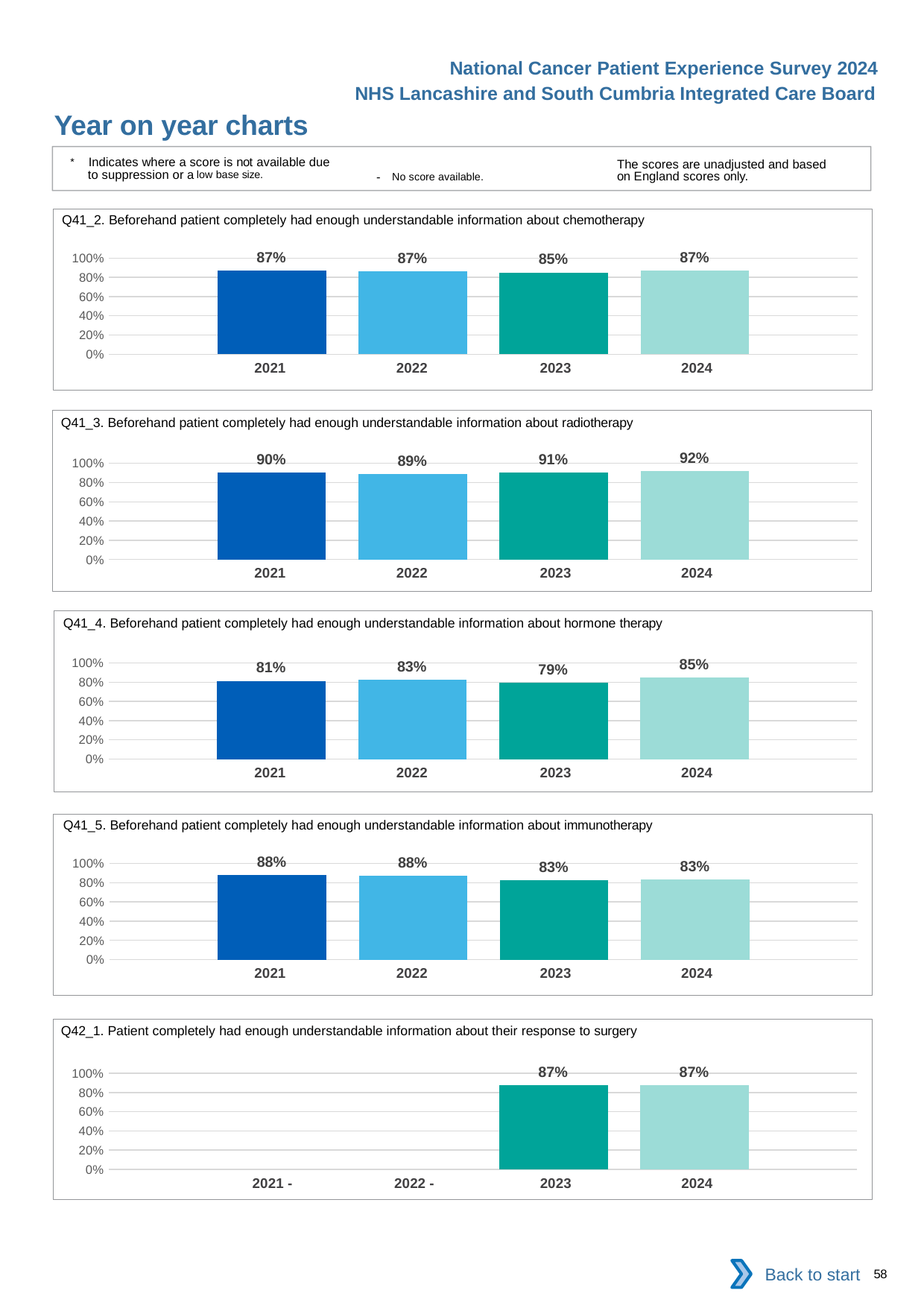
In the Q41_3 chart about radiotherapy, which year has the highest value? 2024 In the Q42_1 chart about response to surgery, how many years have a bar plotted? 2 What kind of chart is the Q41_2 chart about chemotherapy? bar chart In the Q41_2 chart about chemotherapy, what is the value for 2023? 85% In the Q41_3 chart about radiotherapy, is the value for 2021 greater or less than 80%? greater How many charts are shown on the slide? 5 In the Q41_5 chart about immunotherapy, is the value for 2022 larger or smaller than the value for 2023? larger In the Q41_3 chart about radiotherapy, what is the value for 2022? 89% In the Q42_1 chart about response to surgery, what is the value for 2024? 87% In the Q41_4 chart about hormone therapy, what is the difference between the 2024 and 2023 values? 6% In the Q41_4 chart about hormone therapy, which year has the lowest value? 2023 In the Q41_5 chart about immunotherapy, what is the value for 2021? 88%